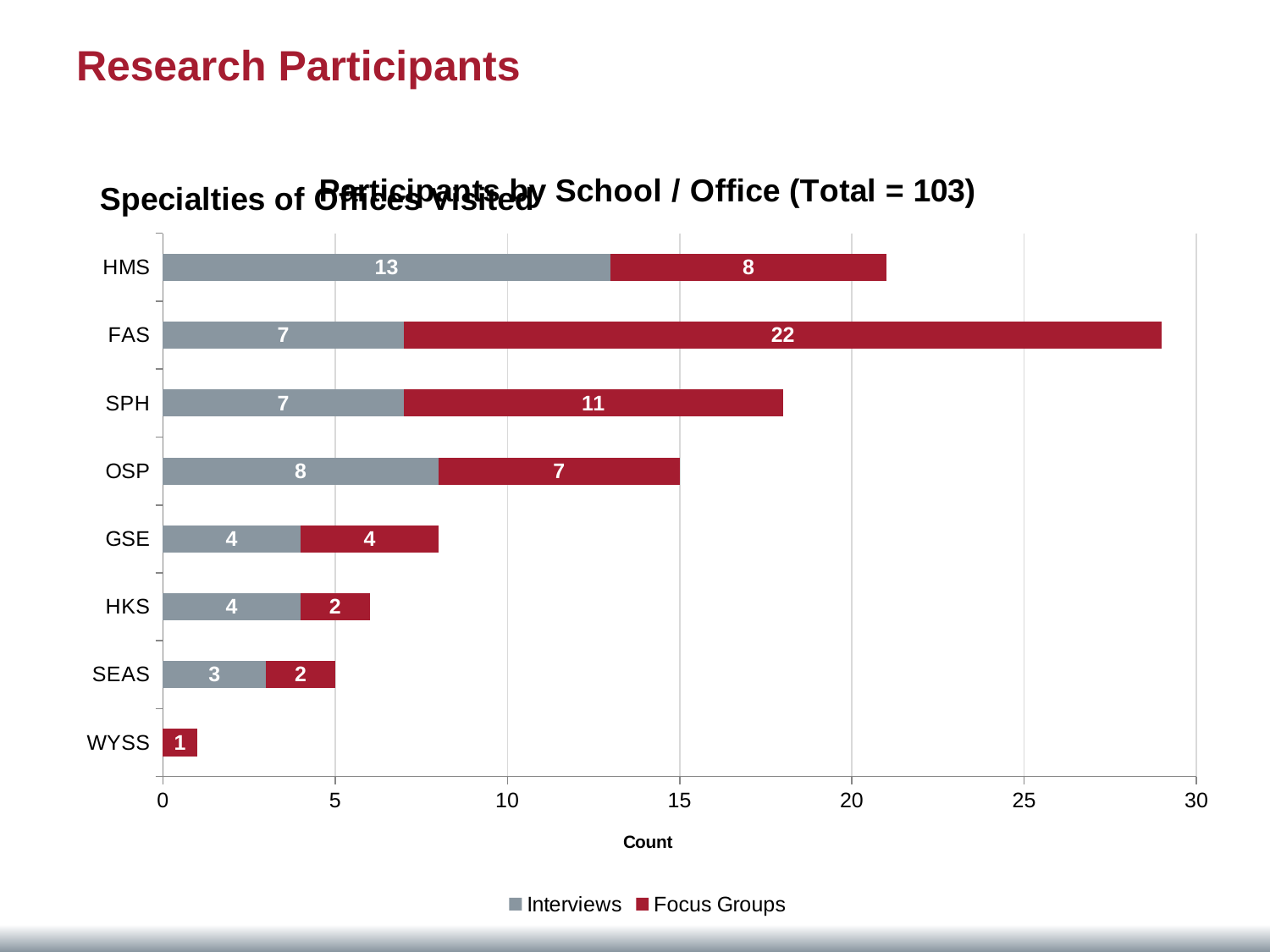
What is the difference between the Focus Groups value for FAS and the Focus Groups value for HMS? 14 What kind of chart is shown on the slide? Stacked bar chart How many series does the legend list? 2 Which is larger for OSP, the Interviews value or the Focus Groups value? Interviews What is the total of the stacked bar for FAS? 29 What is the Focus Groups value for SPH? 11 How many schools or offices are shown on the chart? 8 What is the Focus Groups value for FAS? 22 Which school or office has the shortest total bar? WYSS What is the total of the stacked bar for HMS? 21 What is the Interviews value for HMS? 13 Which school or office has the longest total bar? FAS